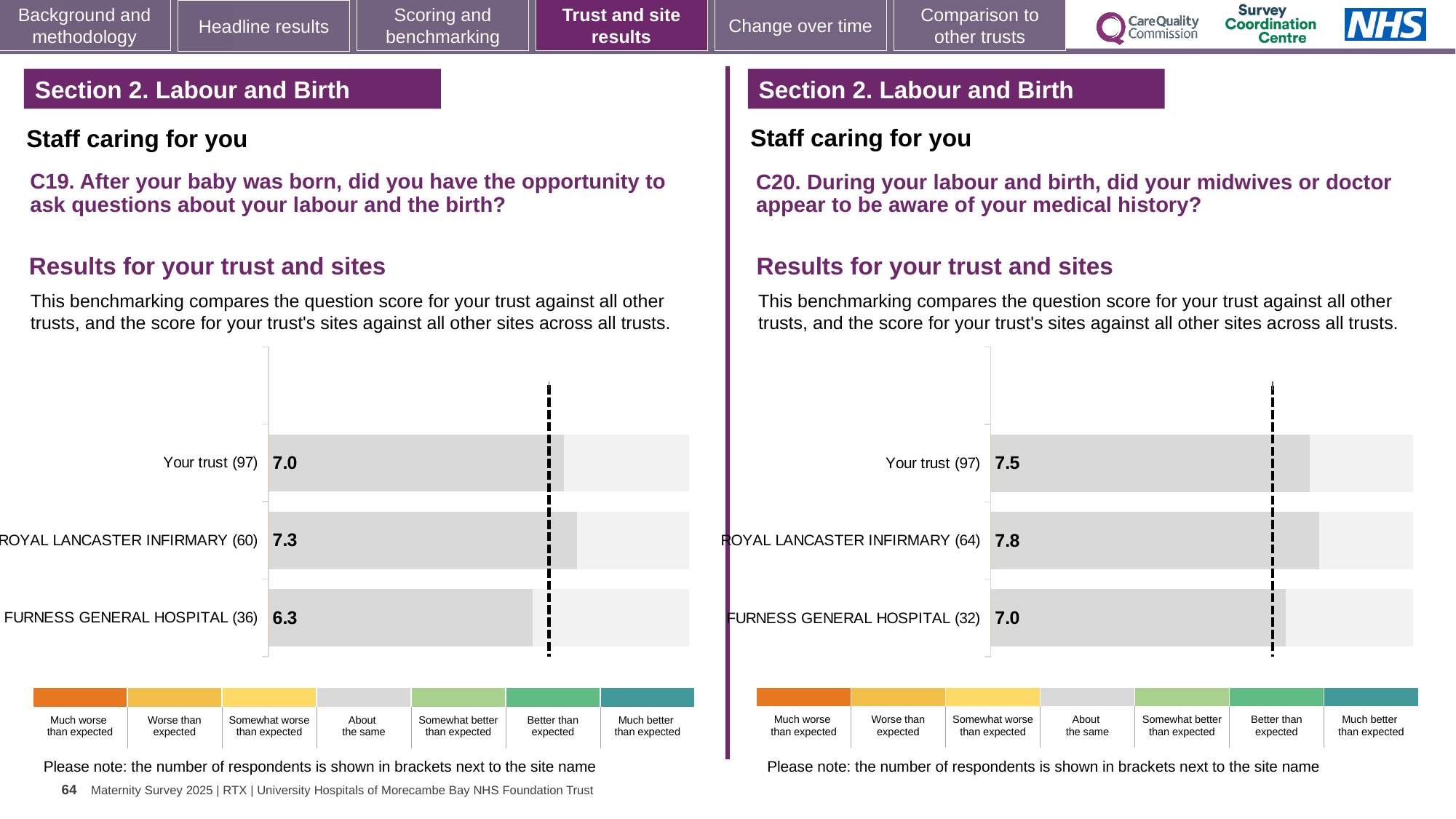
In the C19 chart on the left, what is the score for Your trust? 7.0 In the C19 chart on the left, what is the score for Furness General Hospital? 6.3 In the C19 chart on the left, what is the difference between the scores for Royal Lancaster Infirmary and Furness General Hospital? 1.0 In the C20 chart on the right, what is the score for Furness General Hospital? 7.0 How many bars are plotted in the C19 chart on the left? 3 In the C19 chart on the left, what is the score for Royal Lancaster Infirmary? 7.3 In the C20 chart on the right, which site or trust has the highest score? Royal Lancaster Infirmary What type of chart is used in the C20 chart on the right? Bar chart In the C20 chart on the right, which has the larger score, Your trust or Furness General Hospital? Your trust In the C20 chart on the right, what is the score for Your trust? 7.5 In the C19 chart on the left, which site or trust has the lowest score? Furness General Hospital In the C20 chart on the right, what is the score for Royal Lancaster Infirmary? 7.8